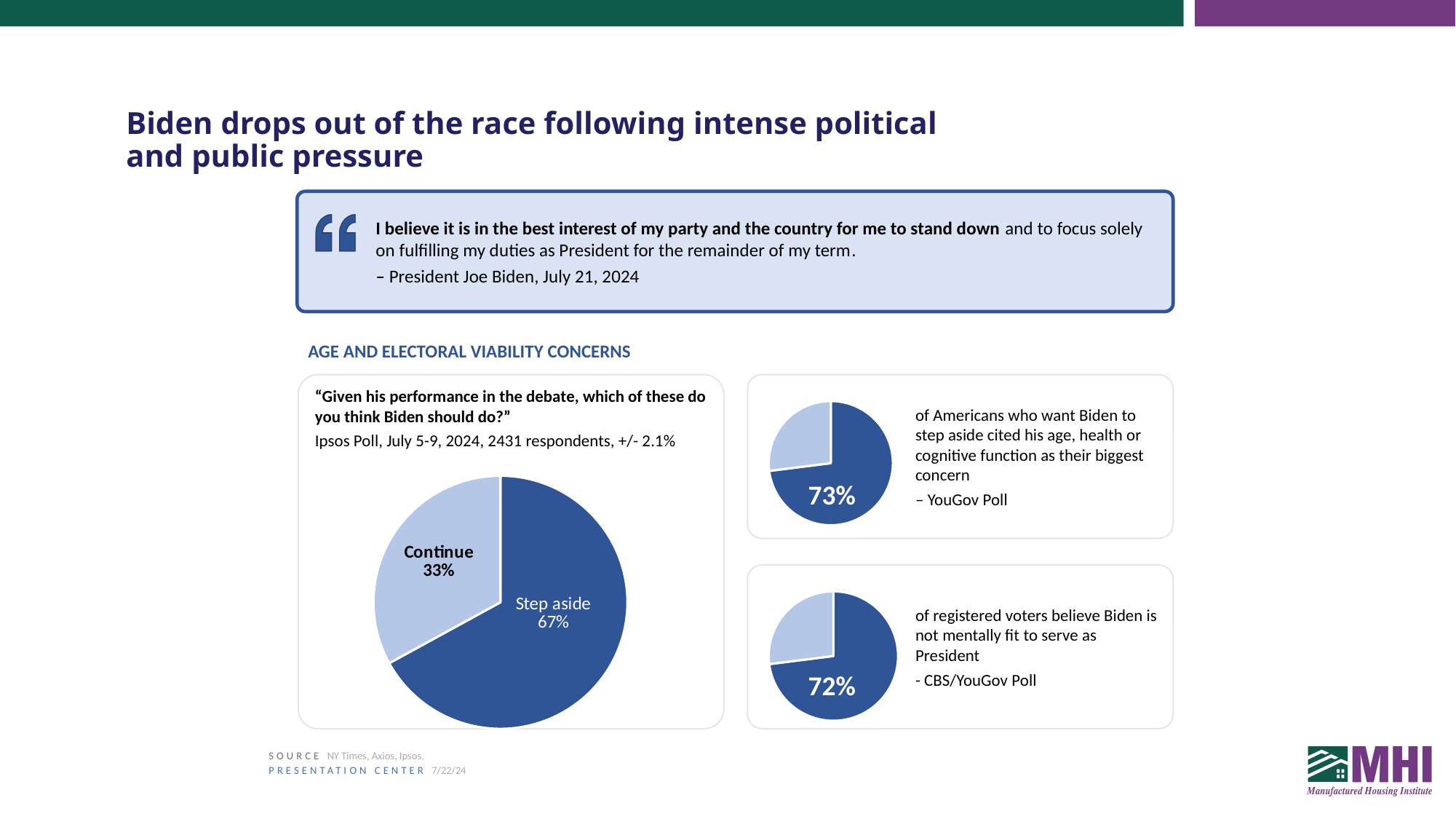
According to the top-right pie chart (YouGov Poll), what percentage of Americans who want Biden to step aside cited his age, health or cognitive function as their biggest concern? 73% According to the bottom-right pie chart (CBS/YouGov Poll), what percentage of registered voters believe Biden is not mentally fit to serve as President? 72% In the Ipsos Poll pie chart, which response has the largest slice? Step aside What type of chart is used to show the Ipsos Poll results on the left of the slide? Pie chart In the Ipsos Poll pie chart, what colour is the "Step aside" slice? Dark blue In the Ipsos Poll pie chart, what percentage chose "Continue"? 33% How many slices does the Ipsos Poll pie chart have? 2 In the Ipsos Poll pie chart, is the share for "Step aside" greater or less than 50%? greater In the Ipsos Poll pie chart, which response has the smallest slice? Continue In the pie chart for the Ipsos Poll question "Given his performance in the debate, which of these do you think Biden should do?", what percentage chose "Step aside"? 67% In the Ipsos Poll pie chart, which is larger: "Step aside" or "Continue"? Step aside In the Ipsos Poll pie chart, what is the difference in percentage points between "Step aside" and "Continue"? 34 percentage points